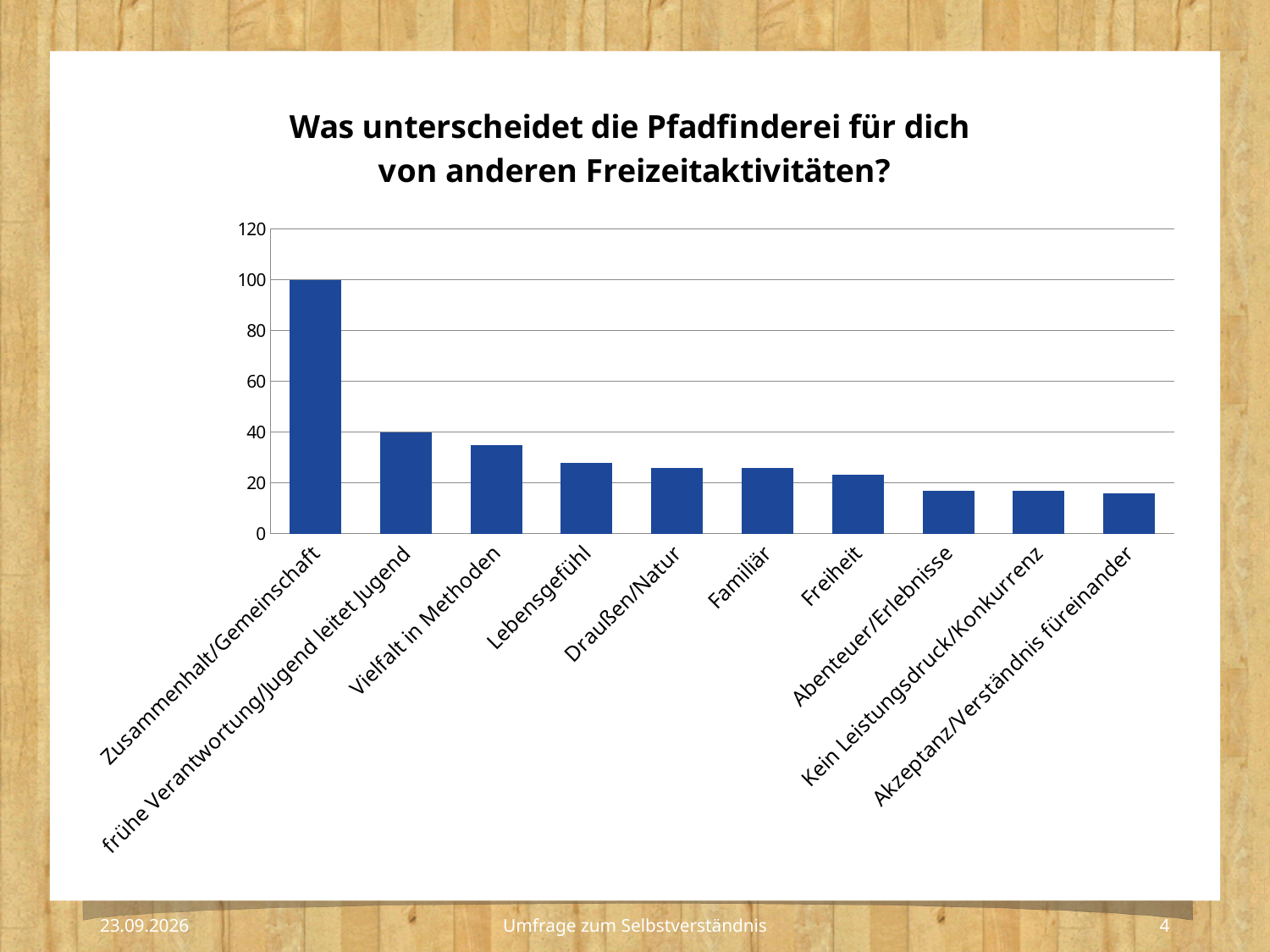
Is the value for Lebensgefühl greater or less than 20? greater How many categories are shown on the x axis of the chart? 10 Which category has the highest value in the chart? Zusammenhalt/Gemeinschaft What kind of chart is shown on the slide? bar chart What is the value for frühe Verantwortung/Jugend leitet Jugend? 40 What is the difference between the values for Zusammenhalt/Gemeinschaft and frühe Verantwortung/Jugend leitet Jugend? 60 Is the value for Akzeptanz/Verständnis füreinander greater or less than 20? less What is the title of the chart? Was unterscheidet die Pfadfinderei für dich von anderen Freizeitaktivitäten? What is the value for Zusammenhalt/Gemeinschaft? 100 Which is larger, the value for Vielfalt in Methoden or the value for Freiheit? Vielfalt in Methoden Is the value for Vielfalt in Methoden greater or less than 40? less Do the values rise or fall from left to right along the x axis? fall